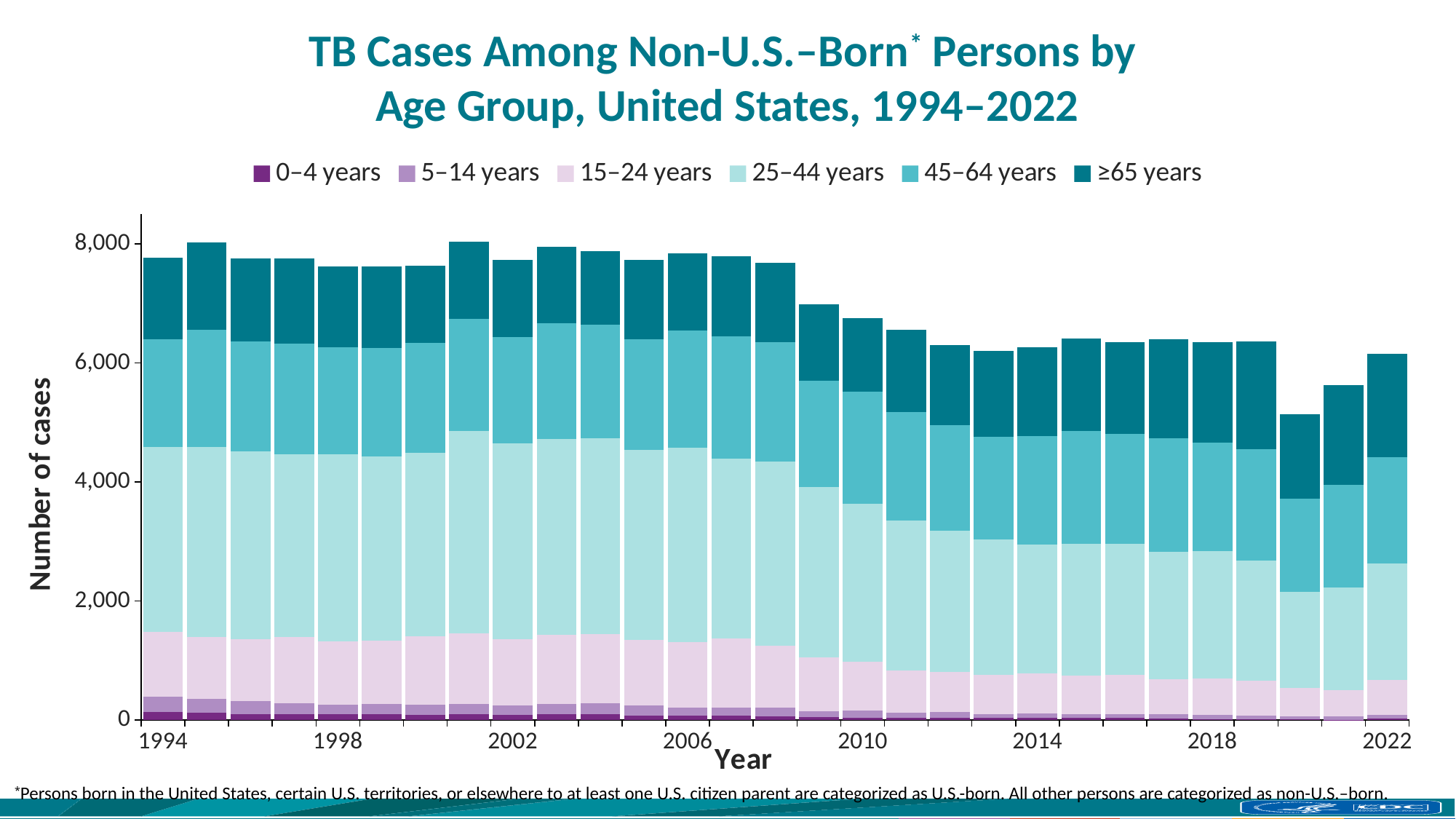
Is the total number of cases for 2020 greater or less than 6,000? less How many years (bars) are plotted on the chart? 29 How many age-group series does the legend list? 6 Is the total number of cases for 2010 greater or less than 6,000? greater Which age group is shown in the darkest teal at the top of each bar? ≥65 years Is the total number of cases for 2014 greater or less than 8,000? less Which year has a larger total number of cases, 2008 or 2020? 2008 What is the label on the y-axis of the chart? Number of cases Which year has the lowest total number of TB cases among non-U.S.-born persons? 2020 Overall, do the total TB case counts rise or fall from 1994 to 2022? fall What kind of chart is shown on the slide? Stacked bar chart